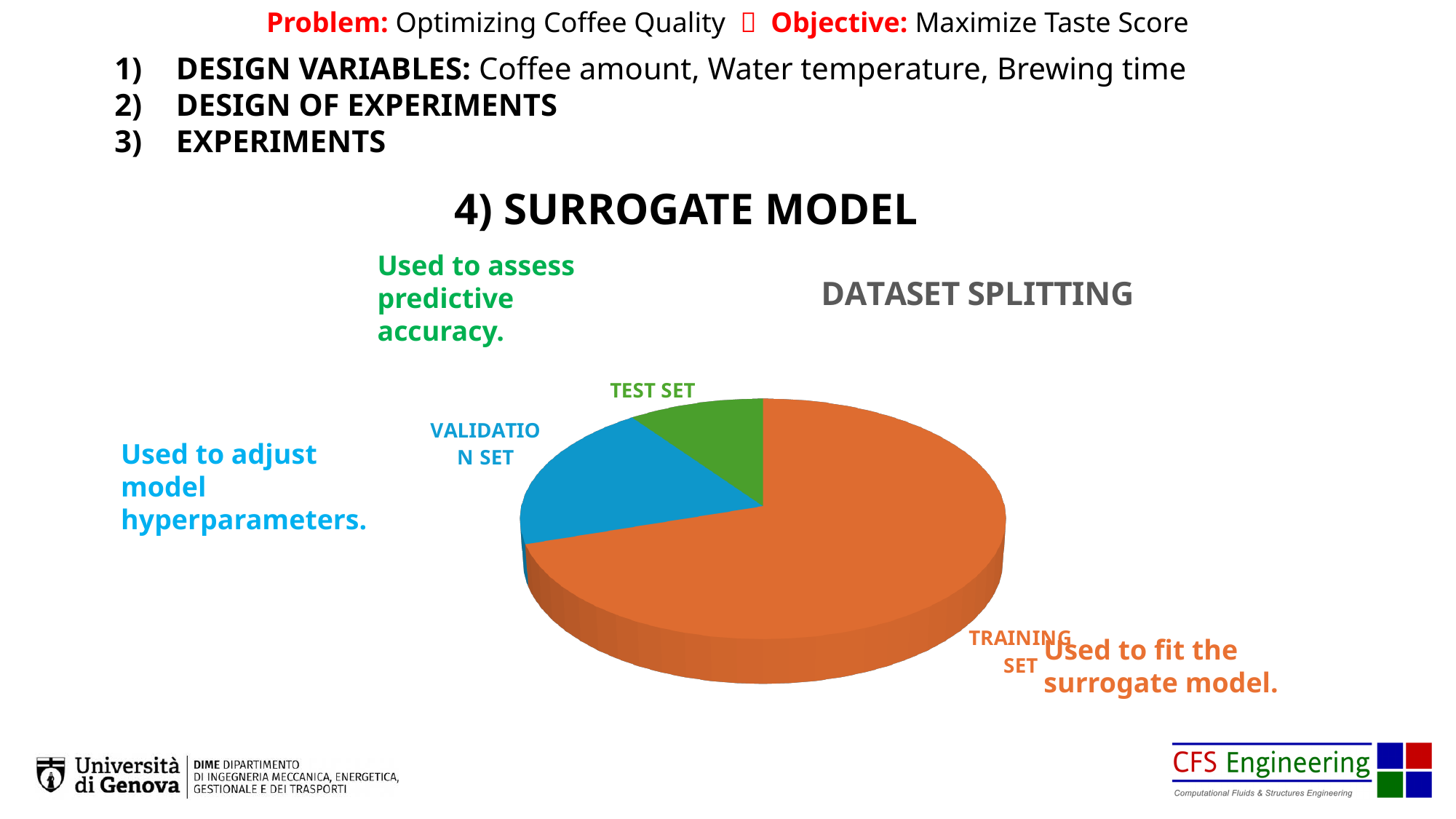
In the DATASET SPLITTING pie chart, which is larger, the VALIDATION SET slice or the TEST SET slice? VALIDATION SET In the DATASET SPLITTING pie chart, which is larger, the TRAINING SET slice or the VALIDATION SET slice? TRAINING SET How many slices does the DATASET SPLITTING pie chart have? 3 Which slice of the DATASET SPLITTING pie chart is the smallest? TEST SET What is the title of the pie chart on the slide? DATASET SPLITTING Which slice of the DATASET SPLITTING pie chart is the largest? TRAINING SET What kind of chart is shown under the heading DATASET SPLITTING? pie chart What colour is the TRAINING SET slice in the DATASET SPLITTING pie chart? orange